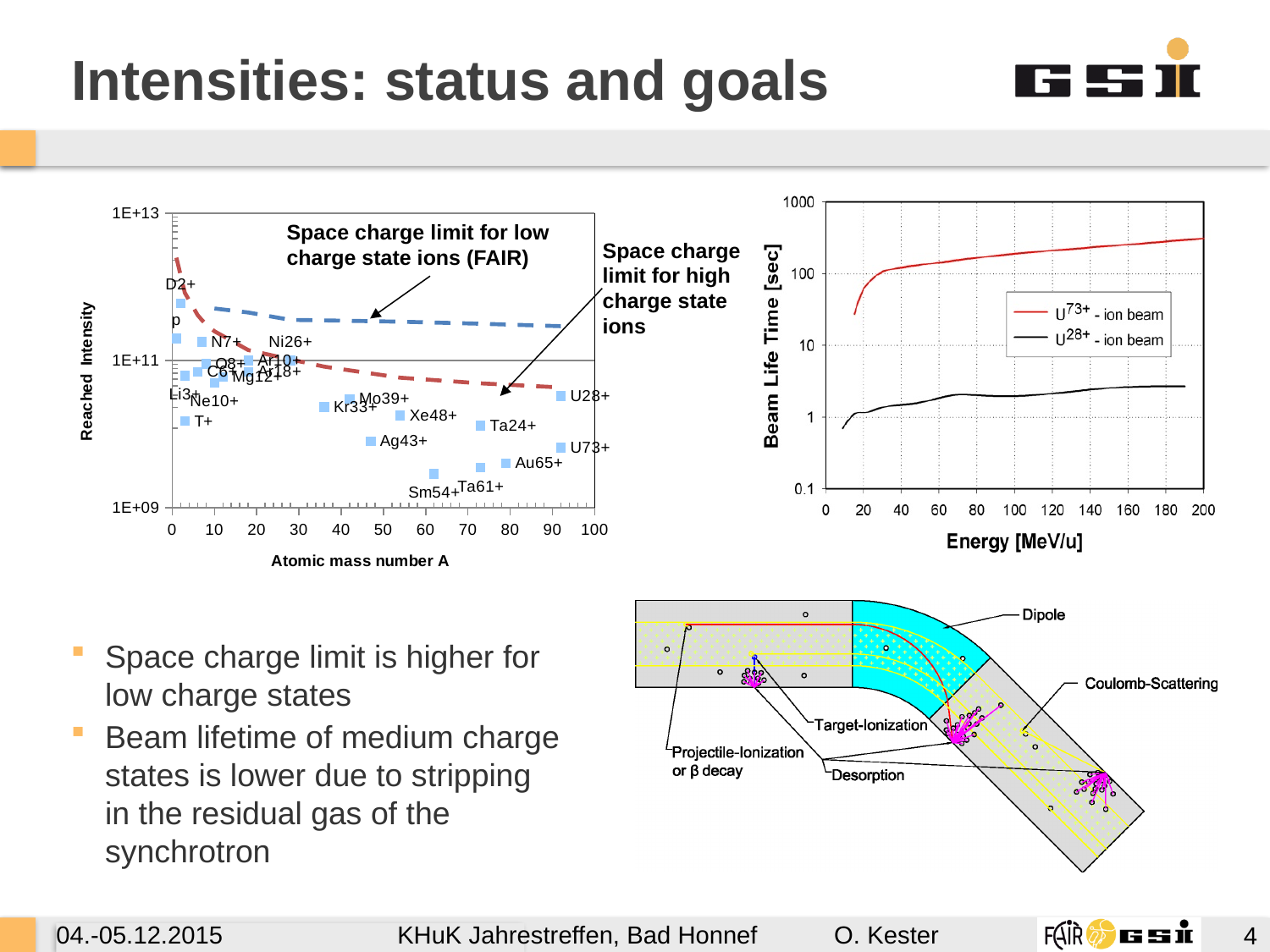
In the left chart (Reached Intensity vs Atomic mass number A), is the reached intensity for U28+ greater or less than 1E+11? less In the right chart (Beam Life Time vs Energy), is the beam lifetime of the U28+ ion beam at 100 MeV/u greater or less than 10 sec? less In the left chart, which dashed line lies higher: the space charge limit for low charge state ions or for high charge state ions? low charge state ions What kind of chart is the left chart showing Reached Intensity versus Atomic mass number A? scatter chart In the left chart (Reached Intensity vs Atomic mass number A), which ion has the highest reached intensity? D2+ In the right chart (Beam Life Time vs Energy), how many series does the legend list? 2 What is the x-axis label of the right chart? Energy [MeV/u] In the left chart (Reached Intensity vs Atomic mass number A), which has the higher reached intensity, U28+ or U73+? U28+ In the right chart (Beam Life Time vs Energy), is the beam lifetime of the U73+ ion beam at 100 MeV/u greater or less than 100 sec? greater In the right chart (Beam Life Time vs Energy), does the beam lifetime of the U73+ ion beam rise or fall as energy increases? rise In the right chart (Beam Life Time vs Energy), which ion beam has the longer beam lifetime, U73+ or U28+? U73+ What kind of chart is the right chart showing Beam Life Time versus Energy? line chart